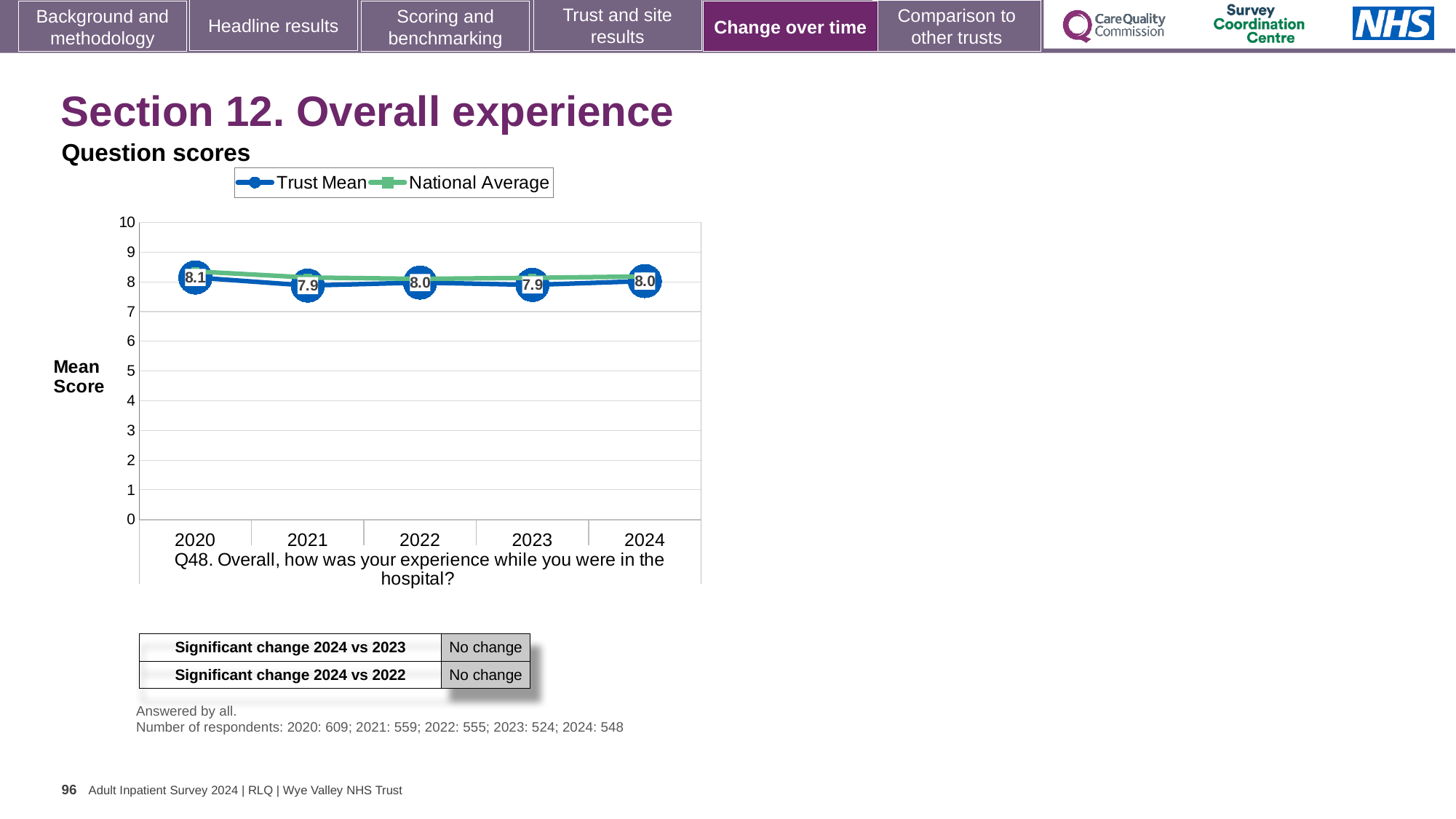
Is the National Average value for 2022 greater or less than 7? greater What is the Trust Mean value for 2022? 8.0 What kind of chart is shown on the slide? Line chart What is the difference between the Trust Mean in 2020 and in 2021? 0.2 What is the Trust Mean value for 2021? 7.9 What are the two series named in the legend? Trust Mean and National Average What is the Trust Mean value for 2024? 8.0 In which year is the Trust Mean highest? 2020 How many series does the legend list? 2 How many years are plotted on the x axis? 5 Is the Trust Mean for 2020 larger than the Trust Mean for 2023? Yes, 2020 (8.1) is larger than 2023 (7.9) What is the Trust Mean value for 2020? 8.1